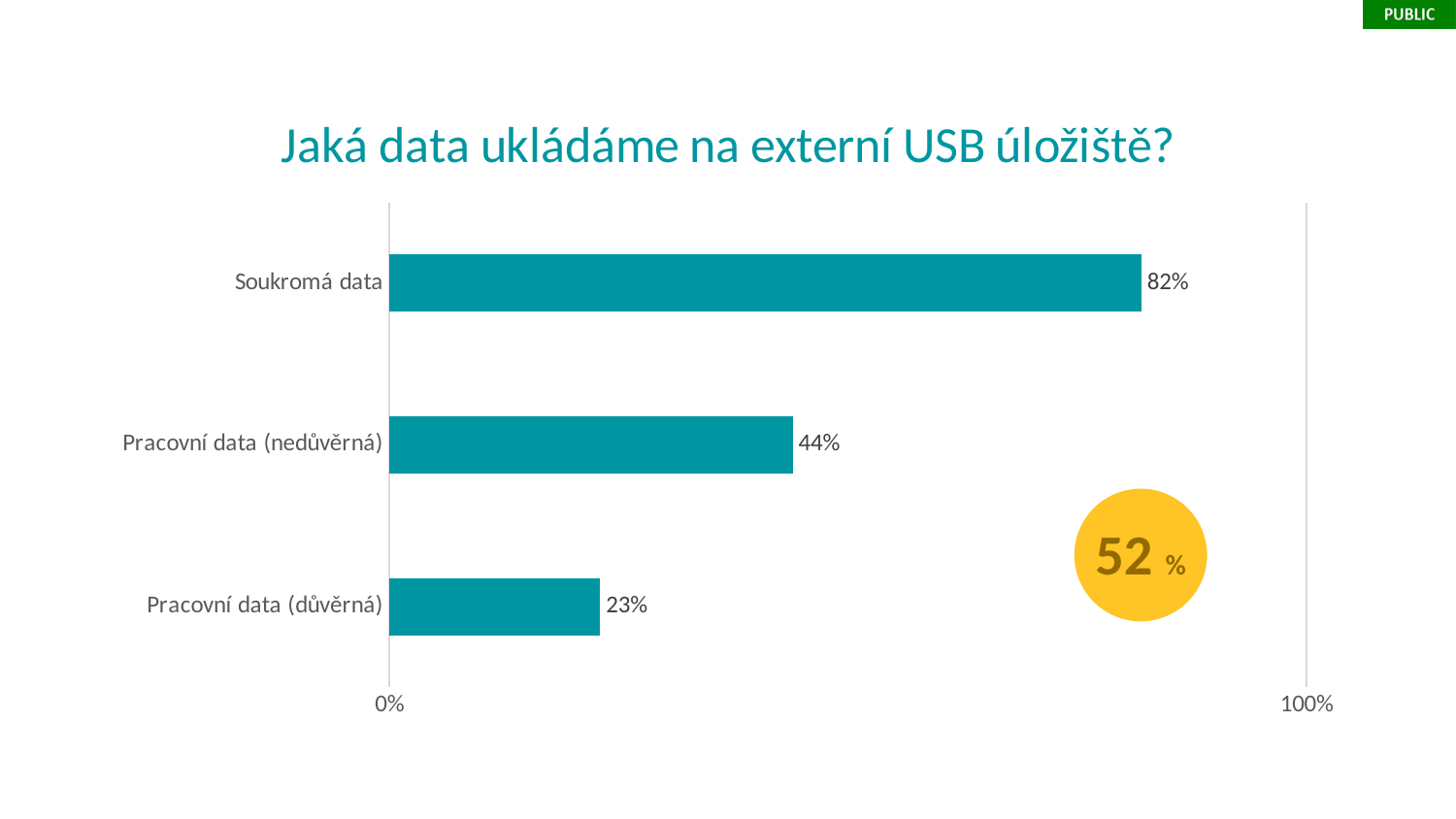
How many categories are shown in the chart? 3 What number is shown in the yellow circle on the slide? 52 % What is the value for Pracovní data (důvěrná)? 23% Which category has the lowest value? Pracovní data (důvěrná) What is the title of the chart? Jaká data ukládáme na externí USB úložiště? What is the difference between the values for Pracovní data (nedůvěrná) and Pracovní data (důvěrná)? 21% Which is larger, the value for Pracovní data (nedůvěrná) or Pracovní data (důvěrná)? Pracovní data (nedůvěrná) What is the difference between the values for Soukromá data and Pracovní data (nedůvěrná)? 38% What is the value for Pracovní data (nedůvěrná)? 44% What is the value for Soukromá data? 82% What kind of chart is shown on the slide? Bar chart Which category has the highest value? Soukromá data